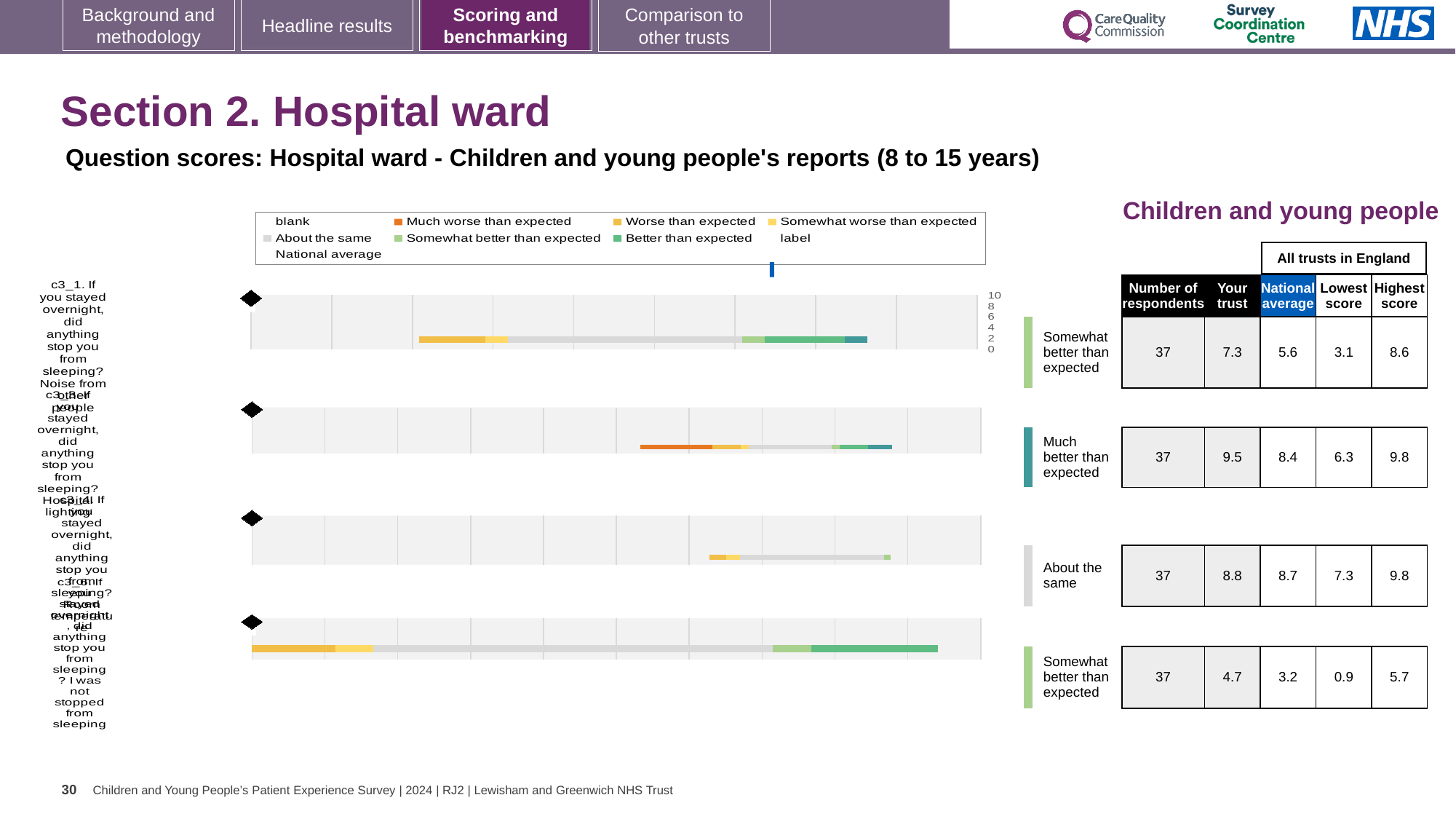
In the table beside the chart, what is the 'Your trust' score for the row labelled 'Much better than expected'? 9.5 In the table beside the chart, what is the difference between the 'Your trust' score and the national average for the row labelled 'Much better than expected'? 1.1 In the table beside the chart, what is the national average for the row labelled 'About the same'? 8.7 In the table beside the chart, for the row labelled 'About the same', which is larger: the 'Your trust' score or the national average? Your trust (8.8) What colour does the legend use for 'Much worse than expected'? orange What colour does the legend use for 'About the same'? grey How many entries does the chart legend list? 9 In the table beside the chart, which row has the highest 'Your trust' score? Much better than expected How many horizontal bars (questions) are plotted in the chart? 4 In the table beside the chart, how many respondents are shown for the row labelled 'Much better than expected'? 37 In the table beside the chart, what is the lowest 'Your trust' score shown? 4.7 What kind of chart is shown on the slide? bar chart